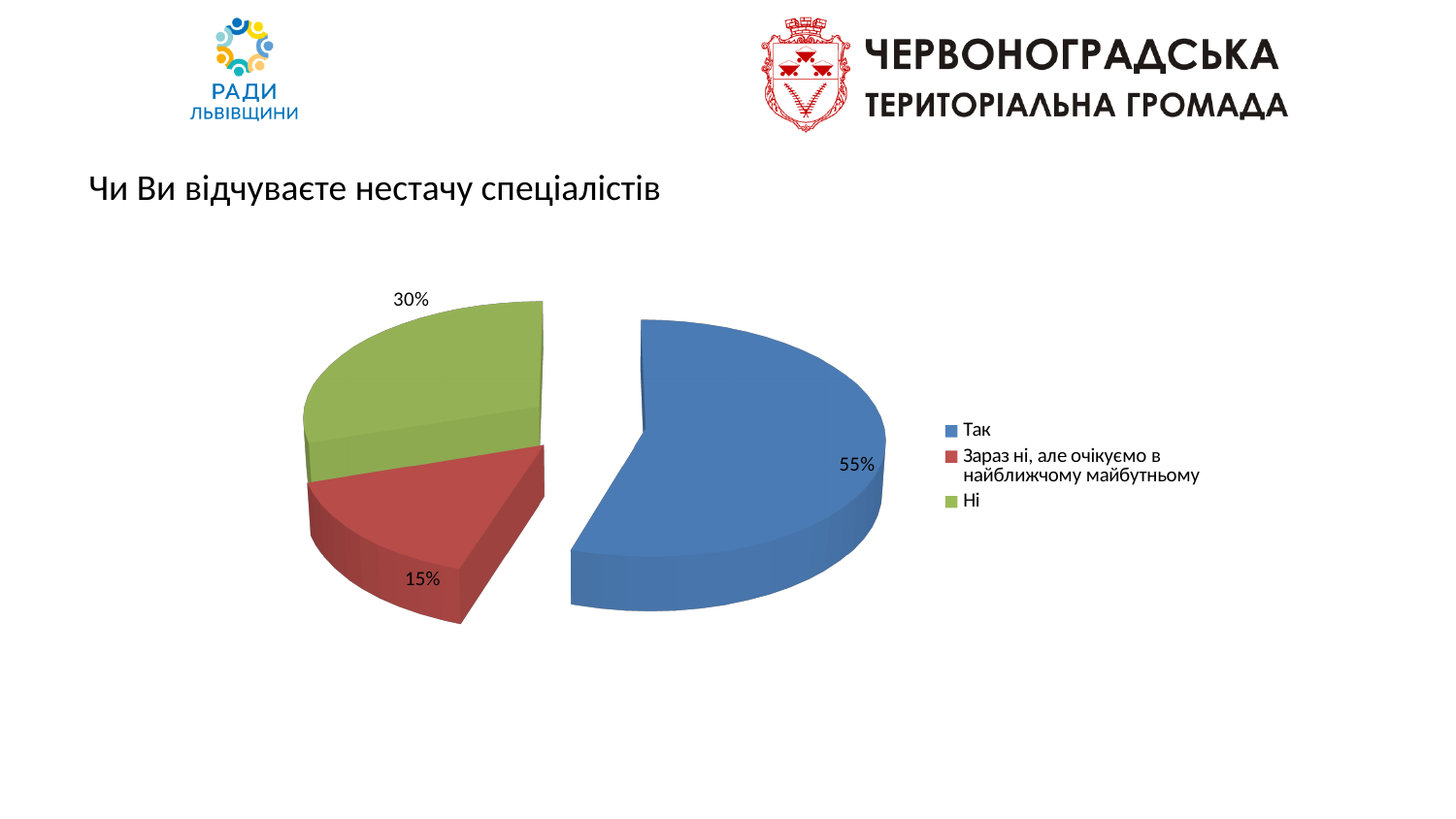
What colour is the slice for "Ні"? green How many slices does the pie chart have? 3 Which category has the largest slice of the pie? Так What kind of chart is shown on the slide? pie chart What share of the pie does "Ні" have? 30% Which category has the smallest slice of the pie? Зараз ні, але очікуємо в найближчому майбутньому What share of the pie does "Зараз ні, але очікуємо в найближчому майбутньому" have? 15% Which is larger, the share for "Ні" or the share for "Зараз ні, але очікуємо в найближчому майбутньому"? Ні What is the difference between the shares for "Так" and "Ні"? 25% What is the title of the question shown above the chart? Чи Ви відчуваєте нестачу спеціалістів What is the difference between the shares for "Ні" and "Зараз ні, але очікуємо в найближчому майбутньому"? 15% What share of the pie does "Так" have? 55%